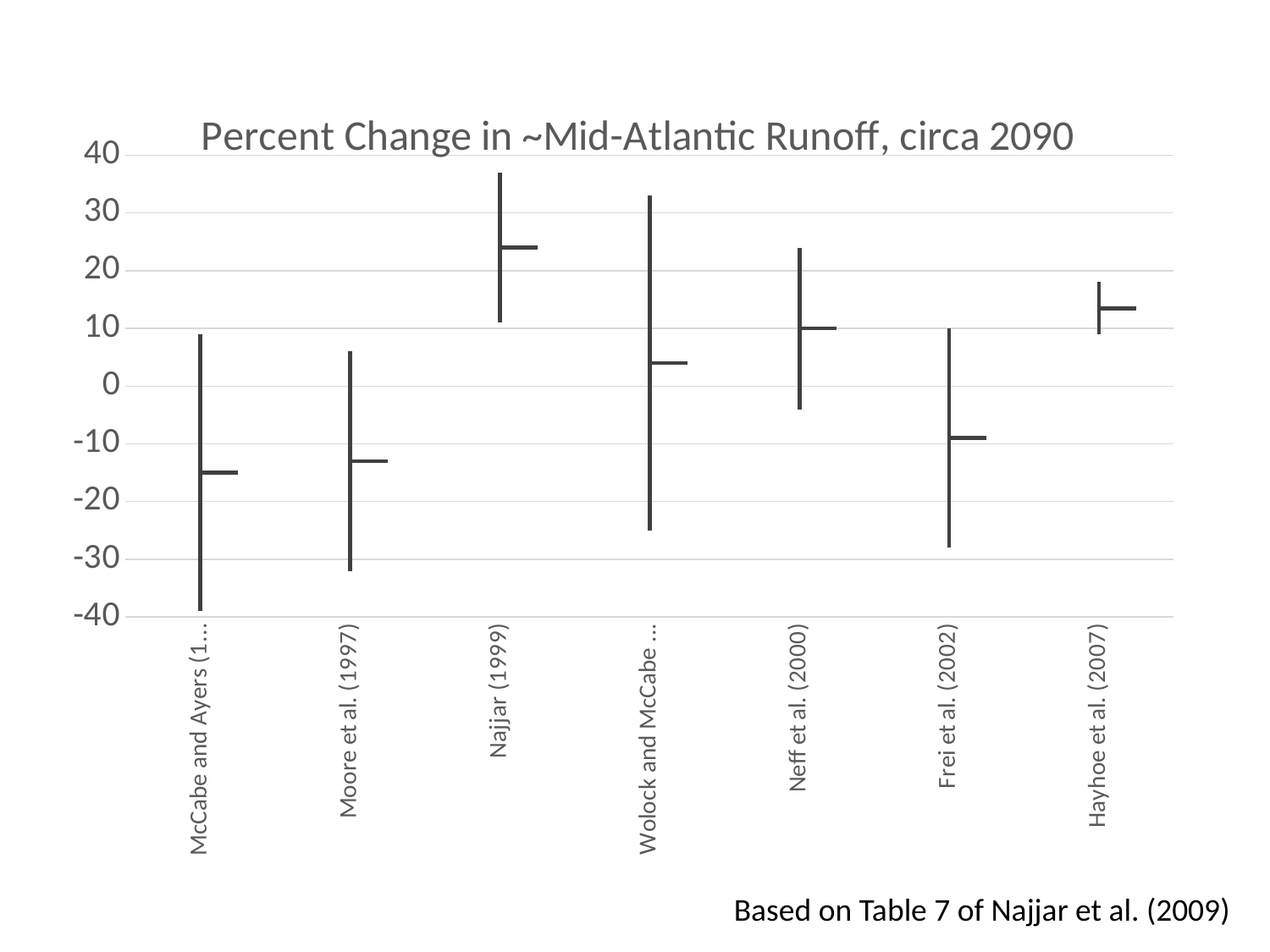
Is the marked value for Moore et al. (1997) greater or less than -10? less Is the marked value for McCabe and Ayers greater or less than -10? less Is the marked value for Najjar (1999) greater or less than 20? greater How many studies are plotted on the x axis? 7 Which has the larger marked value, Najjar (1999) or Hayhoe et al. (2007)? Najjar (1999) What is the title of the chart? Percent Change in ~Mid-Atlantic Runoff, circa 2090 Which has the larger marked value, Wolock and McCabe or Neff et al. (2000)? Neff et al. (2000) Which study has the highest marked value? Najjar (1999)